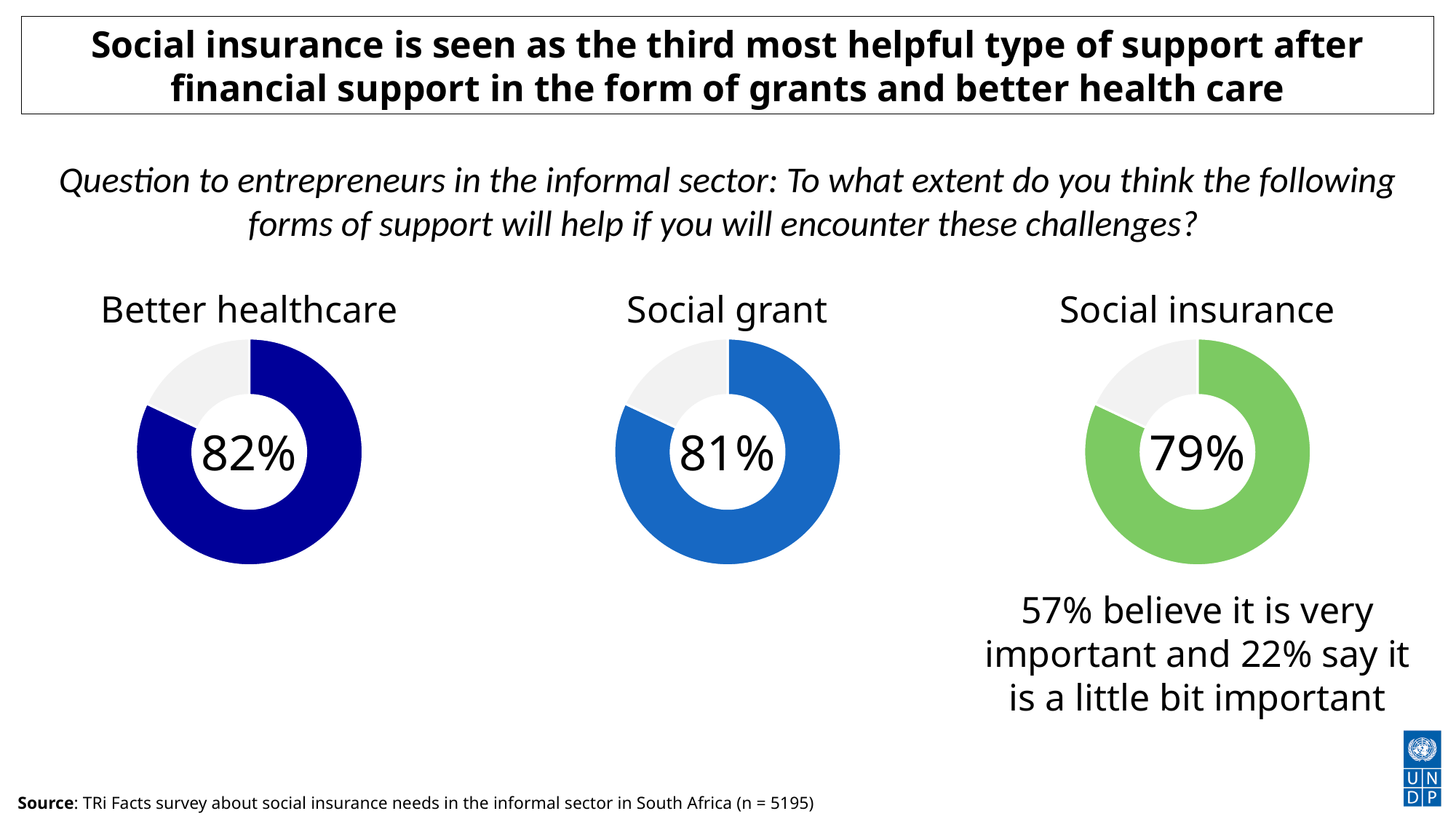
What colour is the filled portion of the Social insurance donut chart? Green What is the difference between the Social grant percentage and the Social insurance percentage? 2% According to the text beside the Social insurance chart, what percentage believe it is very important? 57% What is the difference between the Better healthcare percentage and the Social insurance percentage? 3% How many donut charts are shown on the slide? 3 Which of the three forms of support has the highest percentage? Better healthcare What kind of chart is used to show the Social grant value? Donut chart What percentage is shown in the Social grant donut chart? 81% What percentage is shown in the Better healthcare donut chart? 82% Which has a larger percentage, Social grant or Social insurance? Social grant What percentage is shown in the Social insurance donut chart? 79% Which of the three forms of support has the lowest percentage? Social insurance